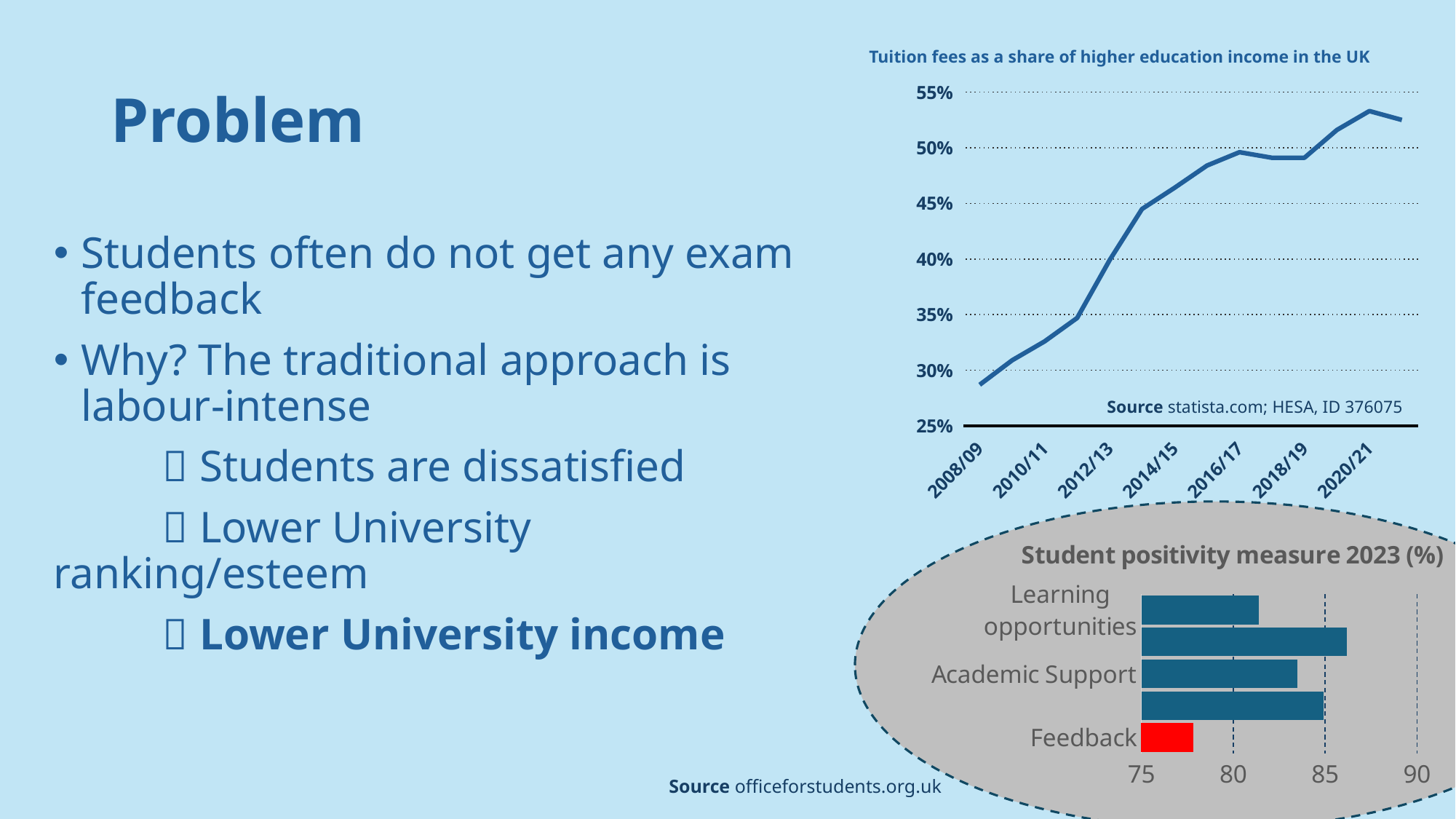
In the 'Tuition fees as a share of higher education income in the UK' chart, is the value for 2010/11 greater or less than 35%? less In the 'Tuition fees as a share of higher education income in the UK' chart, is the value for 2020/21 greater or less than 50%? greater In the 'Tuition fees as a share of higher education income in the UK' chart, is the value for 2008/09 greater or less than 30%? less In the 'Student positivity measure 2023 (%)' chart, which category has the lowest value? Feedback In the 'Tuition fees as a share of higher education income in the UK' chart, which is larger, the value for 2008/09 or the value for 2020/21? 2020/21 How many year labels are shown on the x axis of the 'Tuition fees as a share of higher education income in the UK' chart? 7 What kind of chart is the 'Student positivity measure 2023 (%)' chart? bar chart What kind of chart is the 'Tuition fees as a share of higher education income in the UK' chart? line chart In the 'Student positivity measure 2023 (%)' chart, what colour is the Feedback bar? red In the 'Tuition fees as a share of higher education income in the UK' chart, do the values rise or fall from 2008/09 to 2020/21? rise